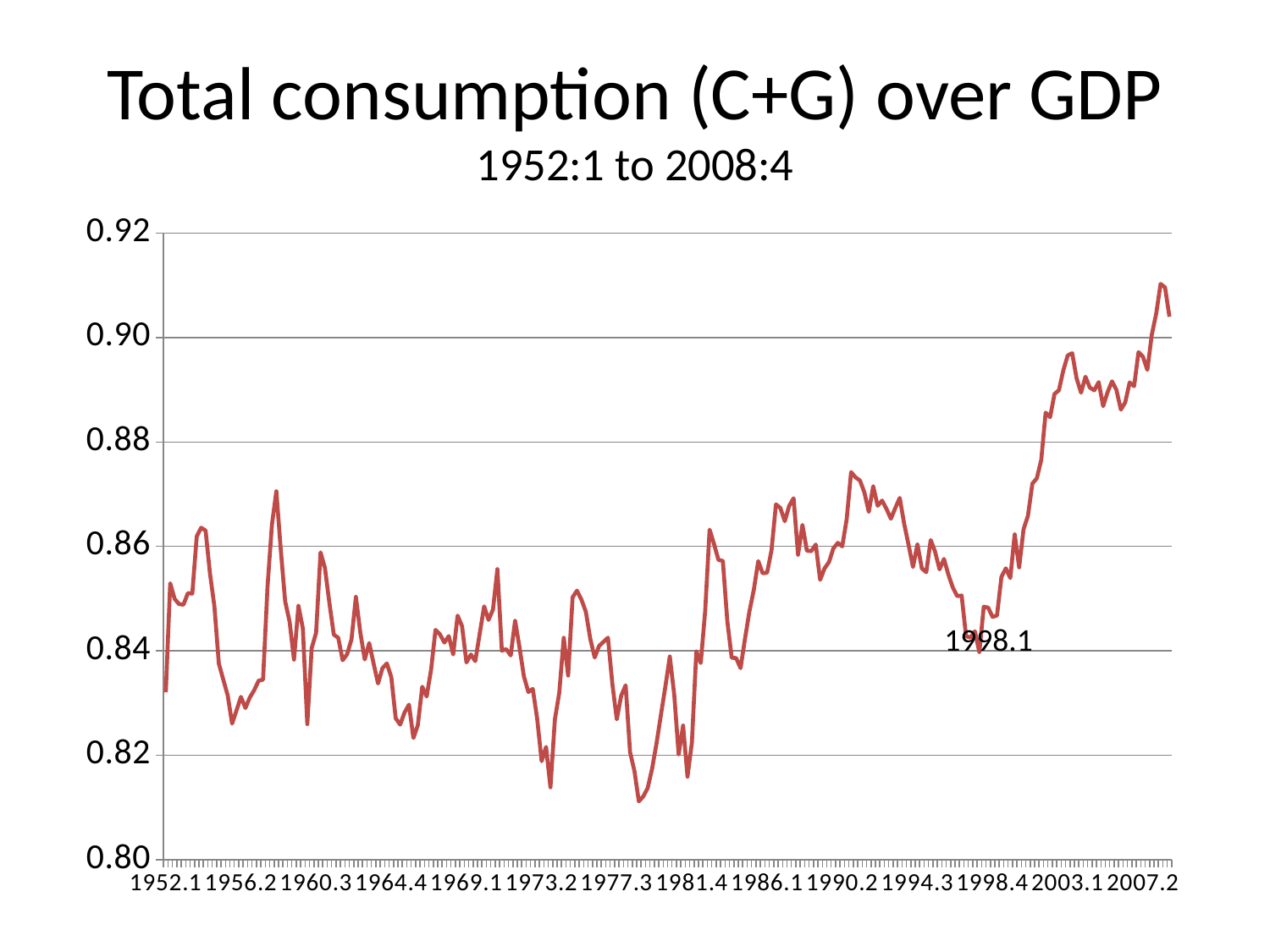
Is the value of the line at 1964.4 greater or less than 0.84? less What kind of chart is shown on the slide? line chart Is the lowest value reached by the line greater or less than 0.82? less What is the title of the chart? Total consumption (C+G) over GDP Does the line rise or fall between 1998.1 and 2007.2? rise What time span does the subtitle of the chart give? 1952:1 to 2008:4 Which is larger, the value of the line at 1952.1 or at 2003.1? 2003.1 Is the highest value reached by the line greater or less than 0.90? greater